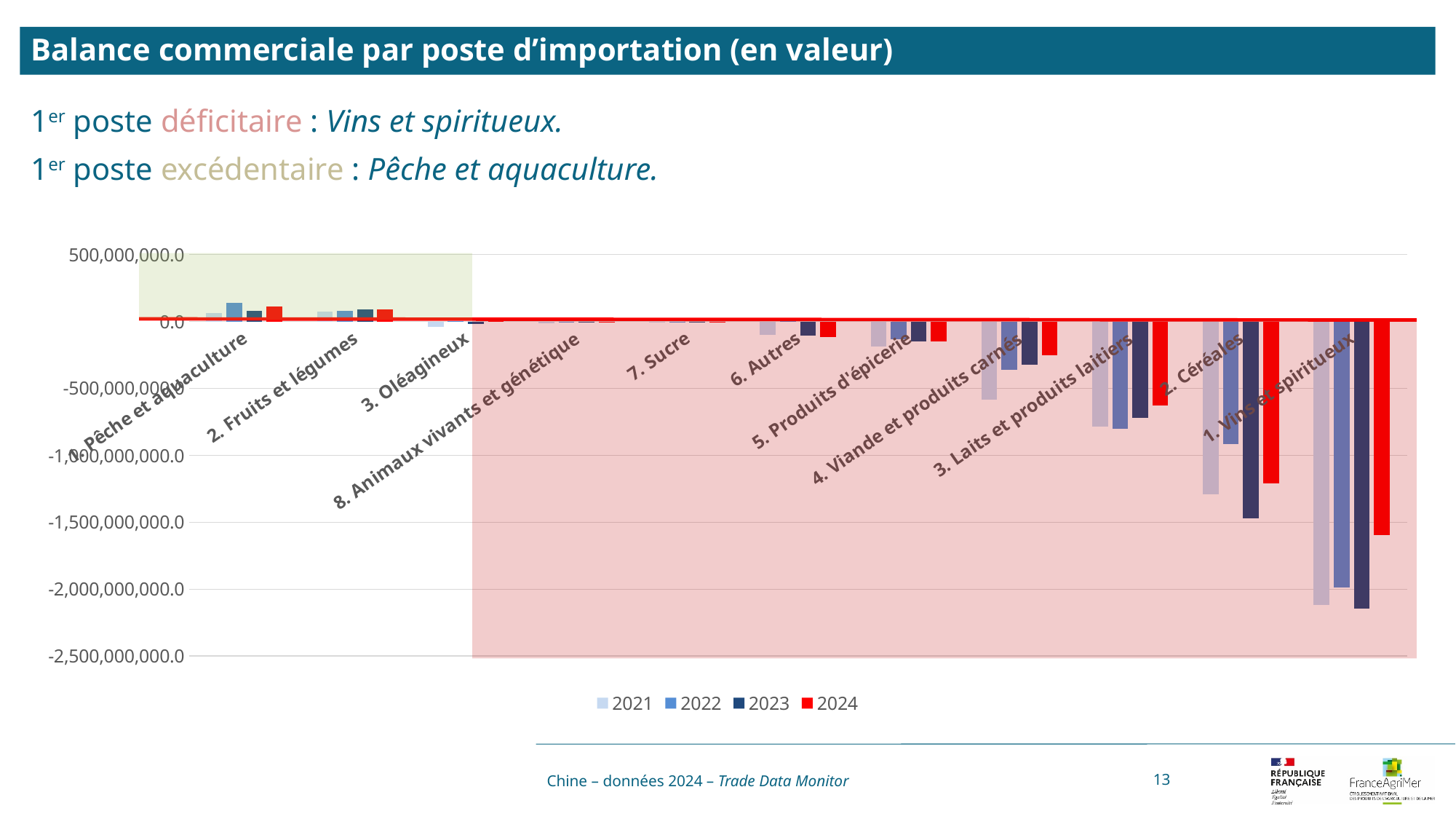
Is the 2024 value for 1. Vins et spiritueux greater or less than -1,500,000,000.0? less Which series shows the lowest value for 1. Vins et spiritueux, 2023 or 2024? 2023 What colour represents the 2024 series in the legend? red How many series does the legend list? 4 Which category has the lowest (most negative) bar in the chart? 1. Vins et spiritueux Is the 2024 value for 2. Céréales greater or less than -1,000,000,000.0? less How many categories are shown on the x axis of the chart? 11 What kind of chart is shown on the slide? bar chart Which category has the lower 2024 value, 2. Céréales or 3. Laits et produits laitiers? 2. Céréales Is the 2023 value for 1. Vins et spiritueux greater or less than -2,000,000,000.0? less Do the values generally rise or fall moving from left to right along the x axis? fall